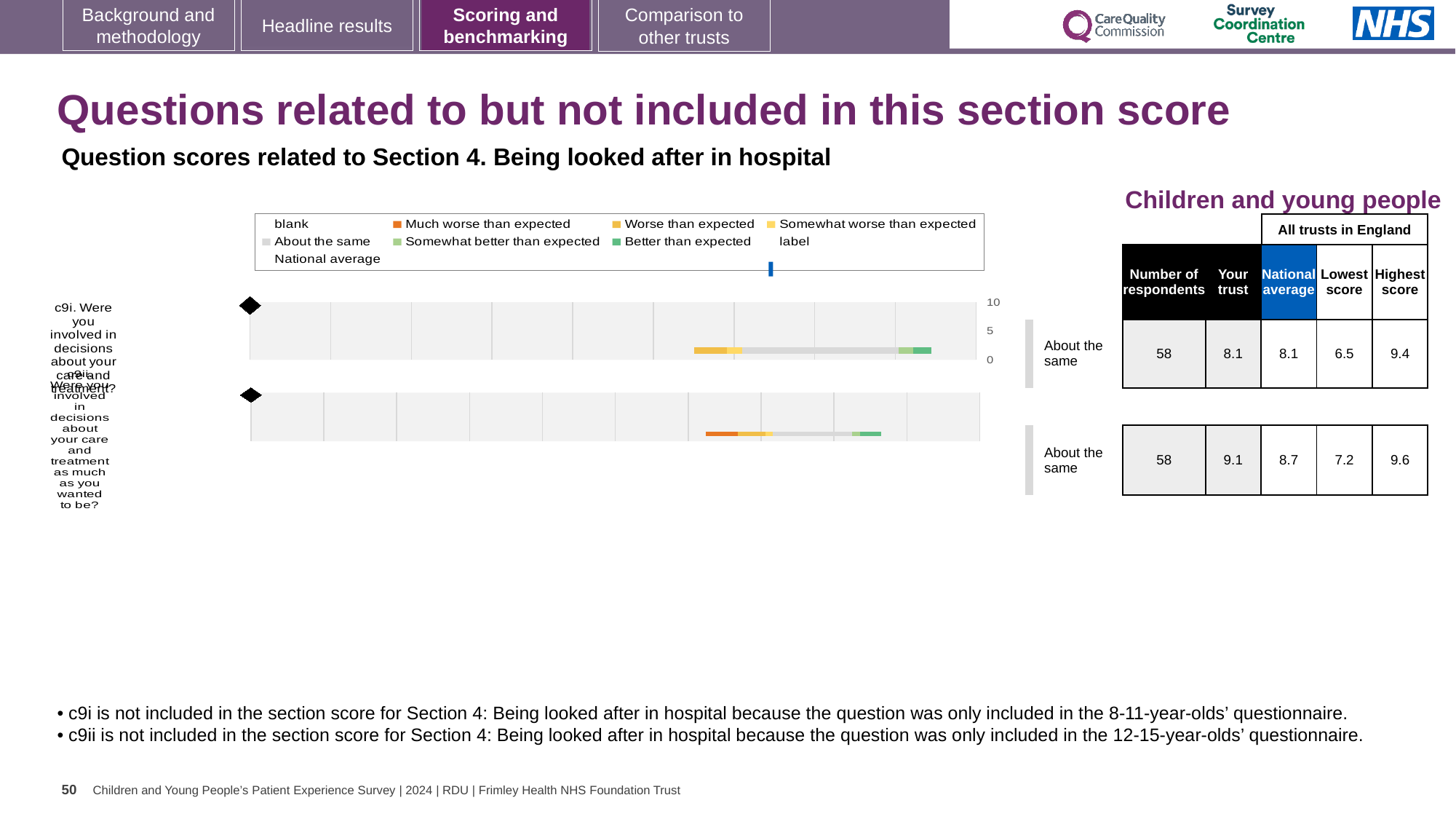
In the table beside the chart, what is the 'Your trust' score for c9ii? 9.1 For c9ii, which is larger: the 'Your trust' score or the national average? Your trust For c9i, what is the difference between the highest score and the lowest score across all trusts in England? 2.9 In the table beside the chart, what is the national average for c9ii? 8.7 What is the highest value shown on the chart's axis? 10 What benchmark category is shown next to the bar for c9i? About the same How many entries does the chart legend list? 9 How many questions (bars) are plotted in the chart? 2 In the table beside the chart, what is the 'Your trust' score for c9i? 8.1 What kind of chart is shown on the slide? bar chart For c9ii, what is the difference between the 'Your trust' score and the national average? 0.4 In the table beside the chart, what is the number of respondents for c9i? 58